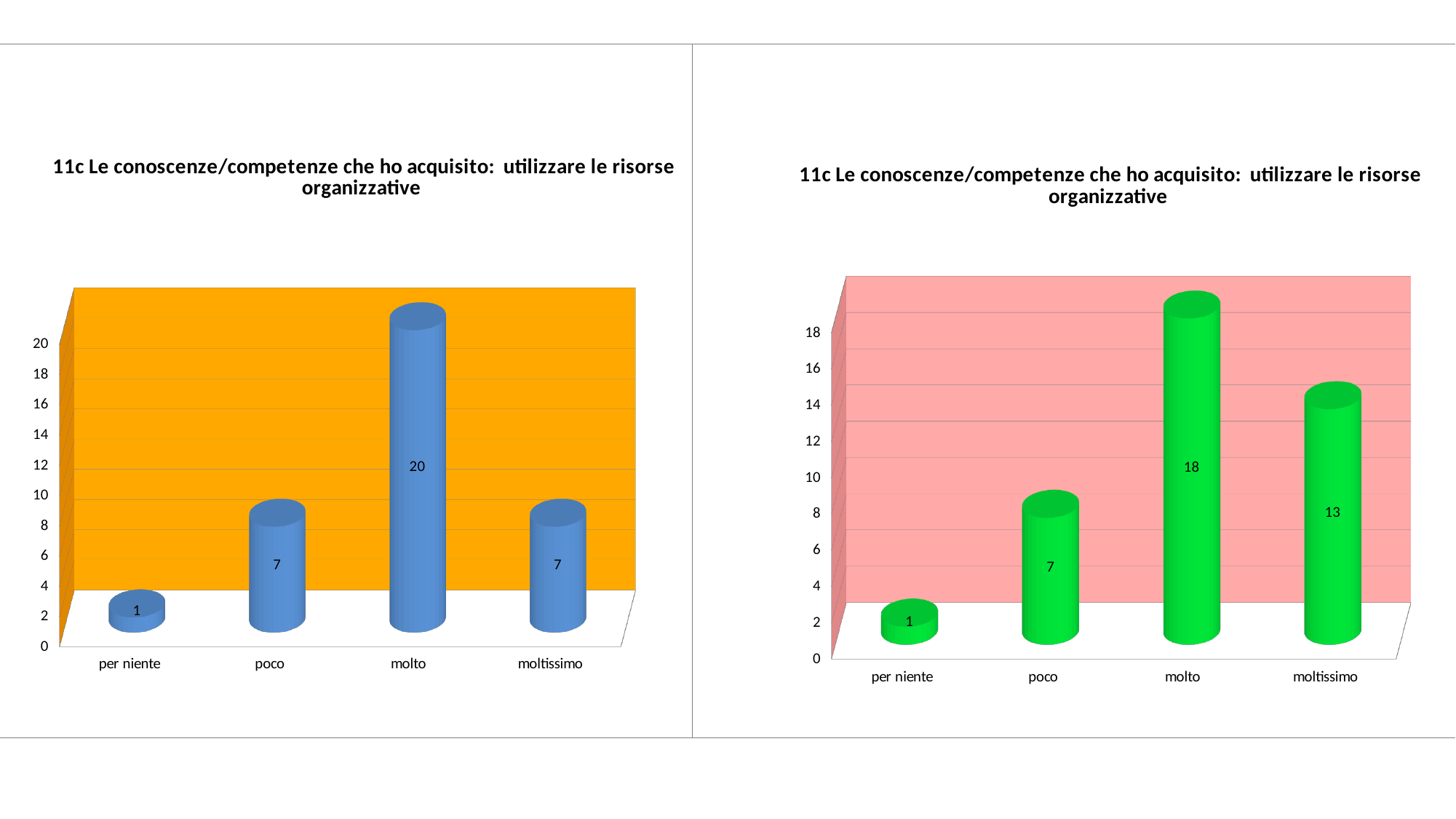
What colour are the bars in the right chart? green In the right chart, what is the value for "molto"? 18 In the right chart, which is larger, the value for "poco" or the value for "moltissimo"? moltissimo In the left chart, which category has the highest value? molto In the right chart, what is the difference between the values for "molto" and "moltissimo"? 5 In the left chart, what is the value for "molto"? 20 In the right chart, which category has the lowest value? per niente In the left chart, what is the value for "per niente"? 1 How many categories are shown on the x axis of the left chart? 4 What kind of chart is the right chart? bar chart In the left chart, what is the difference between the values for "molto" and "poco"? 13 In the right chart, what is the value for "moltissimo"? 13